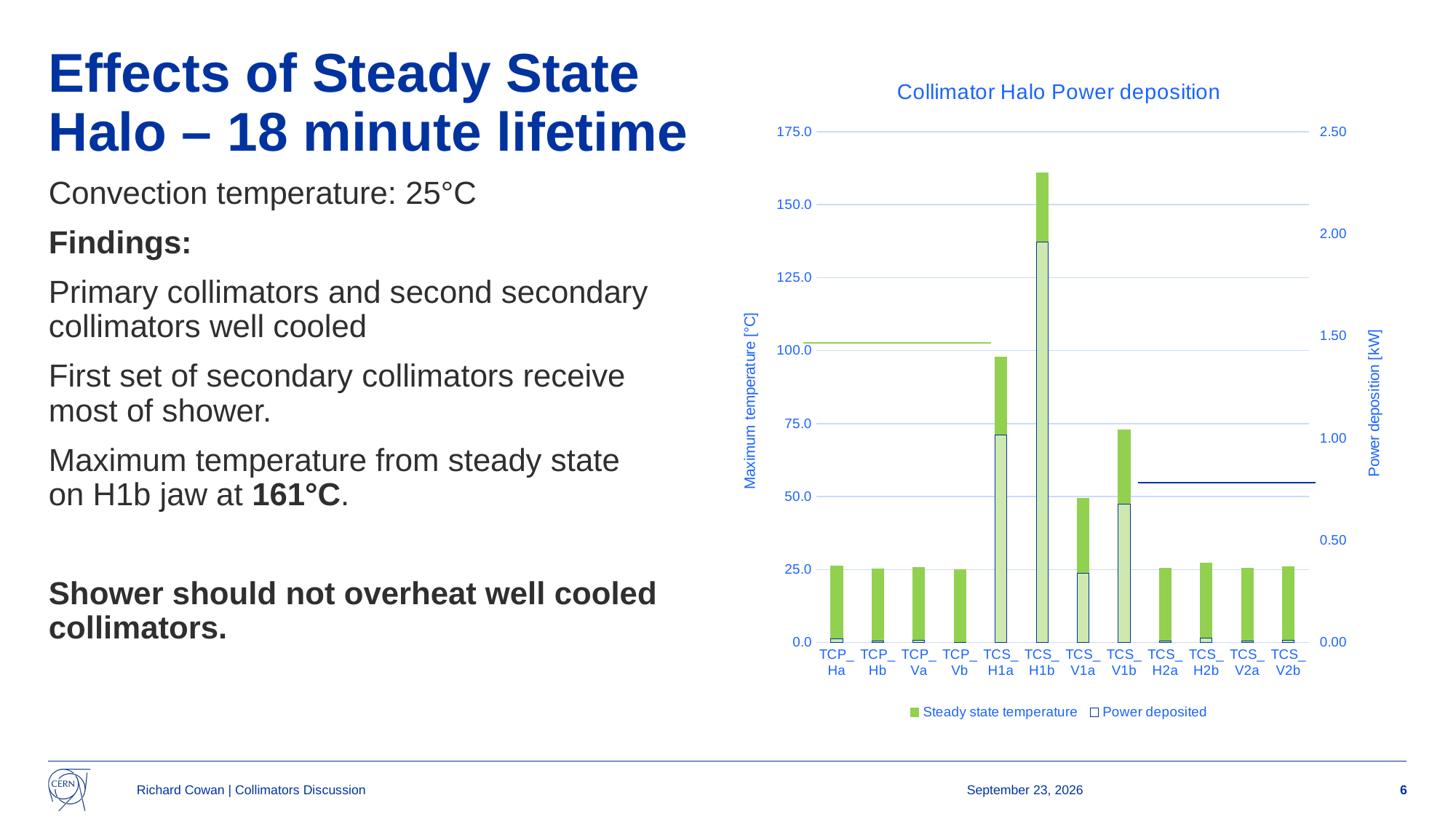
Which collimator has the highest steady state temperature in the chart? TCS_H1b Which collimator has the highest power deposited in the chart? TCS_H1b How many collimator categories are shown on the x axis of the chart? 12 Is the power deposited for TCS_V1b greater or less than 1.00 kW? less What is the title of the chart? Collimator Halo Power deposition How many series does the chart legend list? 2 Is the power deposited for TCS_H1b greater or less than 1.50 kW? greater Is the steady state temperature for TCS_H1b greater or less than 150? greater What kind of chart is shown on the slide? Bar chart Which has the higher steady state temperature, TCS_H1a or TCS_V1b? TCS_H1a What is the label of the right-hand vertical axis of the chart? Power deposition [kW]